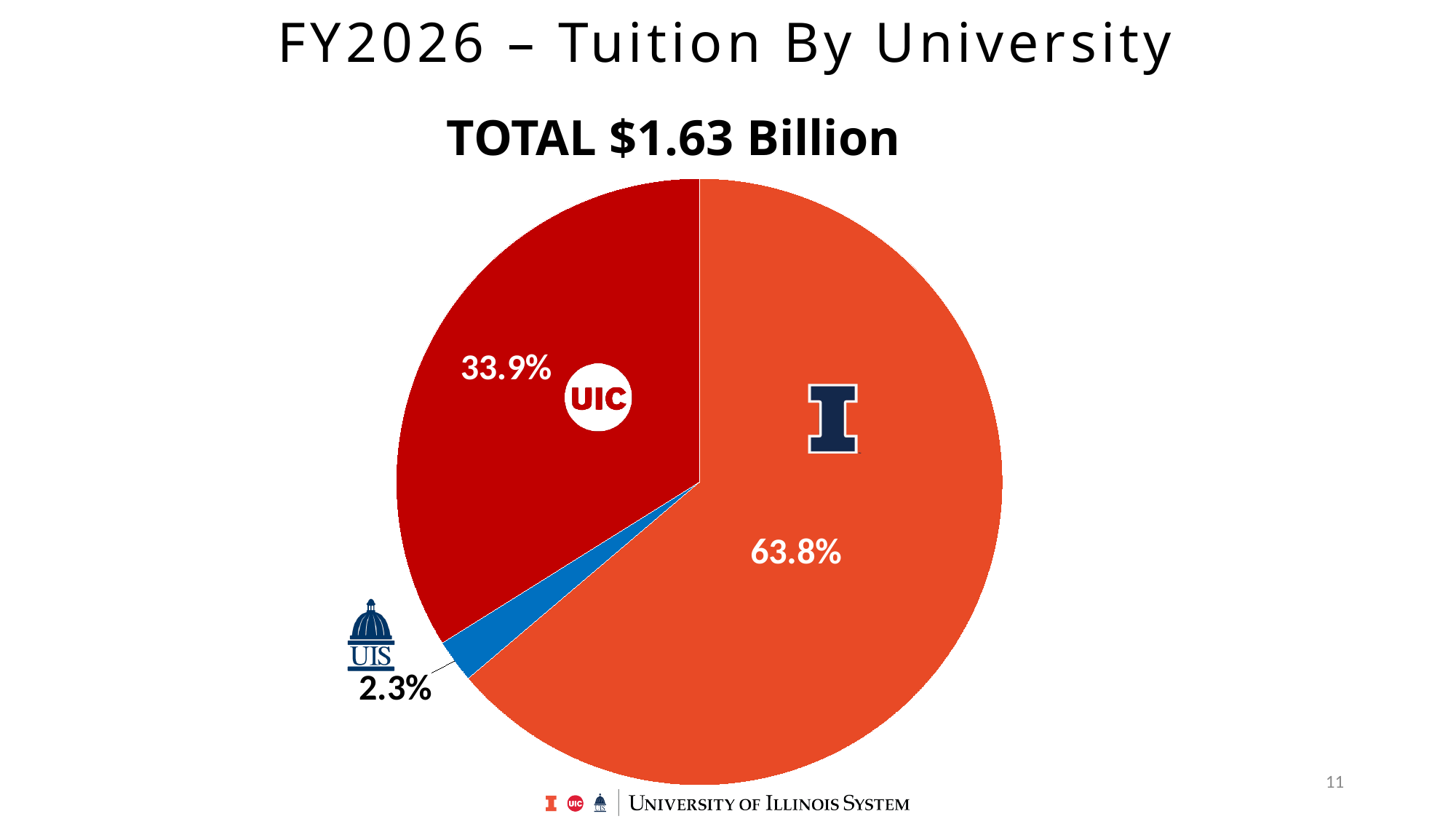
What is the difference in percentage points between the largest slice (63.8%) and the UIC slice? 29.9 percentage points What is the title of the slide? FY2026 – Tuition By University Which is larger, the UIC slice or the UIS slice? UIC What share of the pie does the UIC slice represent? 33.9% Which slice of the pie is the smallest? UIS What total amount is stated above the pie chart? $1.63 Billion Which slice of the pie is the largest? the orange slice with the Block I logo (63.8%) What share of the pie does the UIS slice represent? 2.3% What is the difference in percentage points between the UIC slice and the UIS slice? 31.6 percentage points What share of the pie does the orange slice with the Block I logo represent? 63.8% How many slices does the pie chart have? 3 What kind of chart is shown on the slide? pie chart